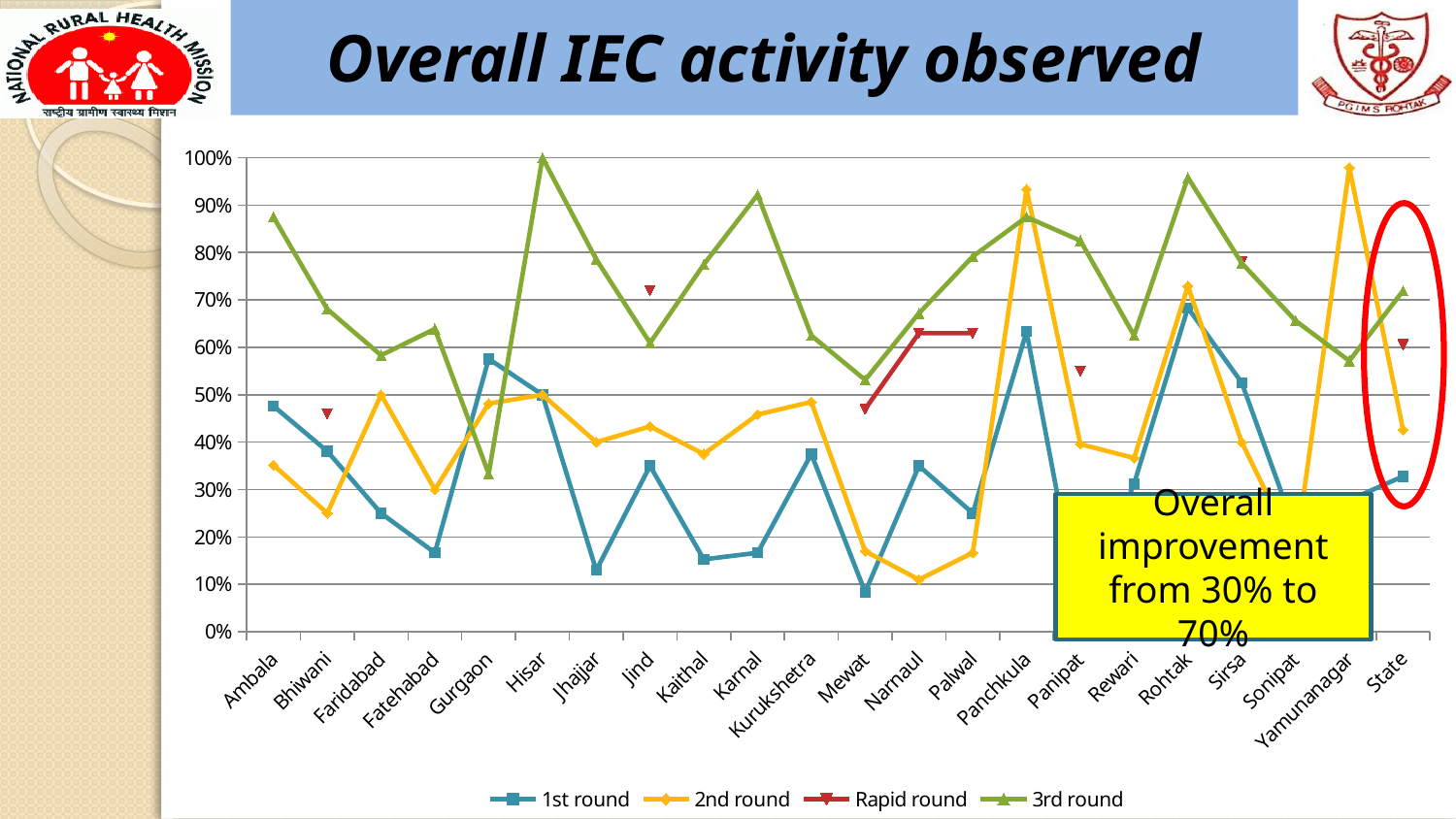
Which category has the highest 2nd round value? Yamunanagar What is the title of the chart? Overall IEC activity observed For Panchkula, which is larger: the 1st round value or the 2nd round value? 2nd round What is the 3rd round value for Hisar? 100% What kind of chart is shown on the slide? line chart How many series does the legend list? 4 Which category has the highest 3rd round value? Hisar Is the 1st round value for Fatehabad greater or less than 20%? less Is the 3rd round value for Rohtak greater or less than 90%? greater Is the 3rd round value for Ambala greater or less than 80%? greater How many categories are shown along the x axis? 22